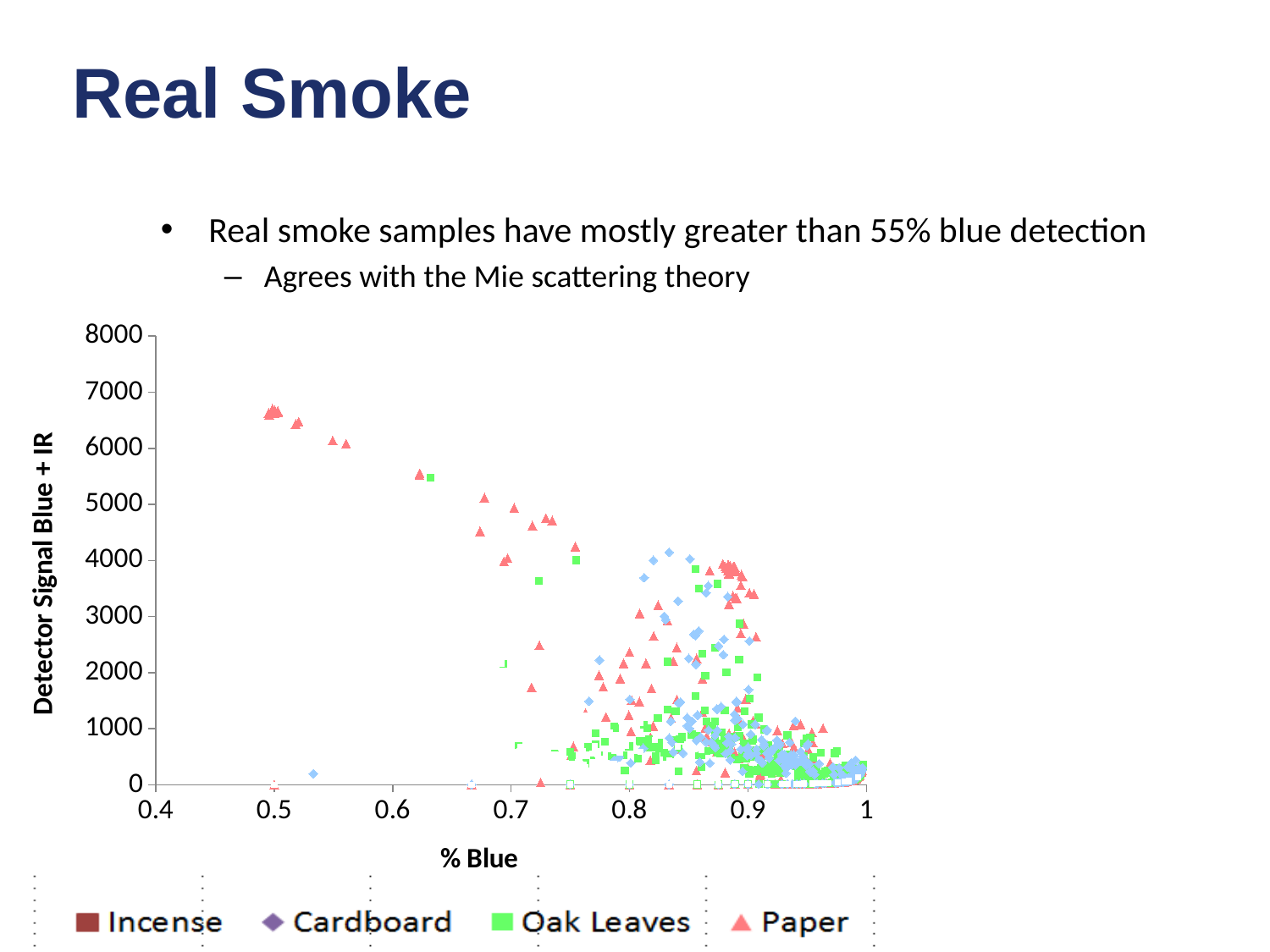
Which series in the legend is shown with triangle markers? Paper What is the maximum value shown on the y axis of the chart? 8000 Are the Paper points plotted at about 0.5 % Blue greater or less than 6000 on the y axis? greater Do the Paper values generally rise or fall as % Blue increases from 0.5 to 1? fall What kind of chart is shown on the slide? scatter chart Which series has the points with the highest Detector Signal Blue + IR values on the chart? Paper How many series does the chart's legend list? 4 What is the title of the chart's y axis? Detector Signal Blue + IR Which series has points at the lowest % Blue values on the chart? Paper